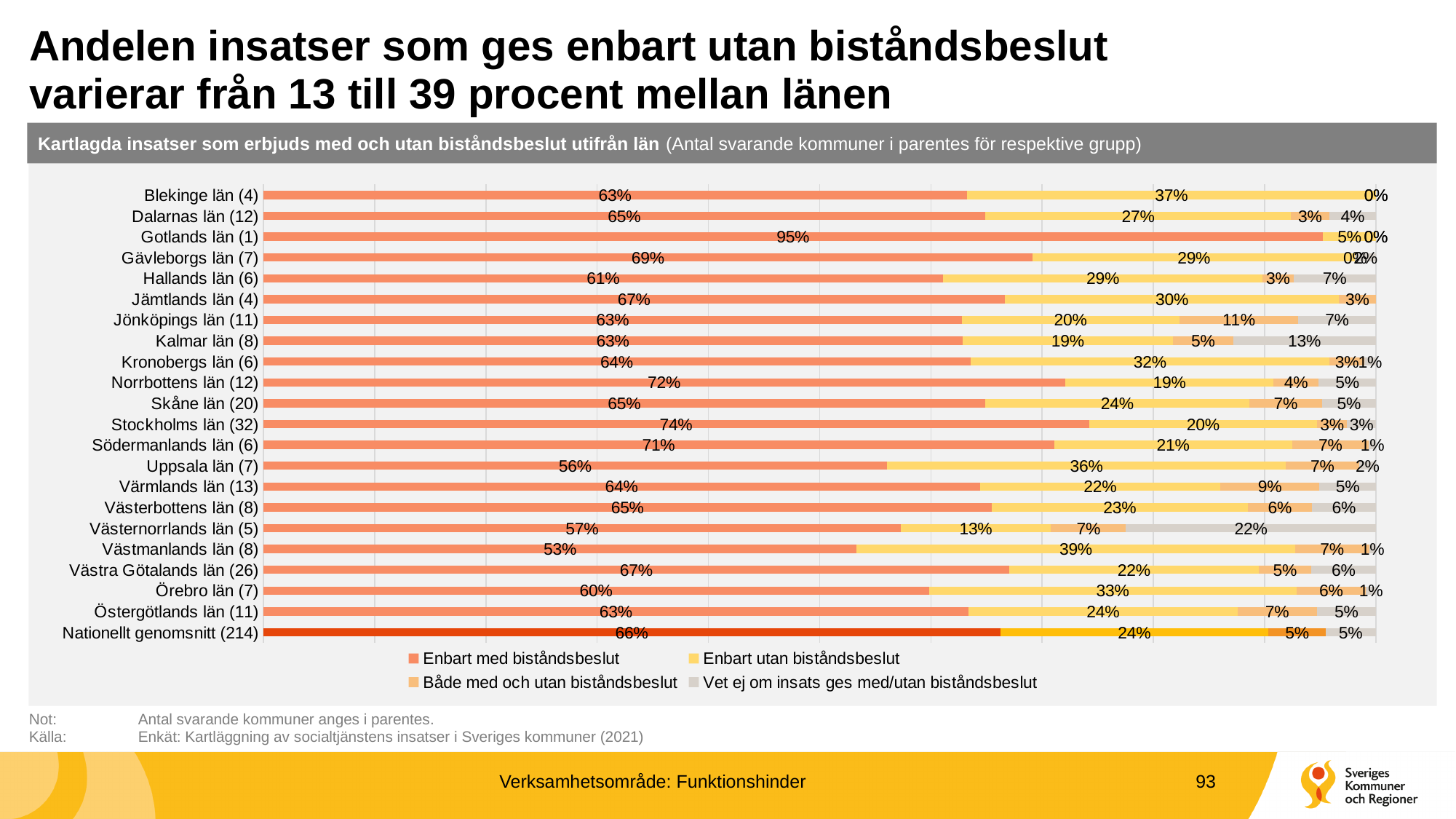
Which län has the highest 'Enbart med biståndsbeslut' share? Gotlands län (1) What is the 'Vet ej om insats ges med/utan biståndsbeslut' value for Västernorrlands län (5)? 22% What kind of chart is shown on the slide? Stacked bar chart Which län has the highest 'Vet ej om insats ges med/utan biståndsbeslut' share? Västernorrlands län (5) How many series does the legend list? 4 What is the difference in percentage points between the 'Enbart med biståndsbeslut' values for Gotlands län (1) and Västmanlands län (8)? 42 percentage points How many categories (rows) are shown in the chart? 22 What is the 'Enbart utan biståndsbeslut' value for Västmanlands län (8)? 39% Which län has the lowest 'Enbart med biståndsbeslut' share? Västmanlands län (8) What percentage of insatser in Gotlands län (1) are given 'Enbart med biståndsbeslut'? 95% Which has a larger 'Enbart med biståndsbeslut' share, Stockholms län (32) or Norrbottens län (12)? Stockholms län (32) What is the 'Enbart med biståndsbeslut' value for Nationellt genomsnitt (214)? 66%